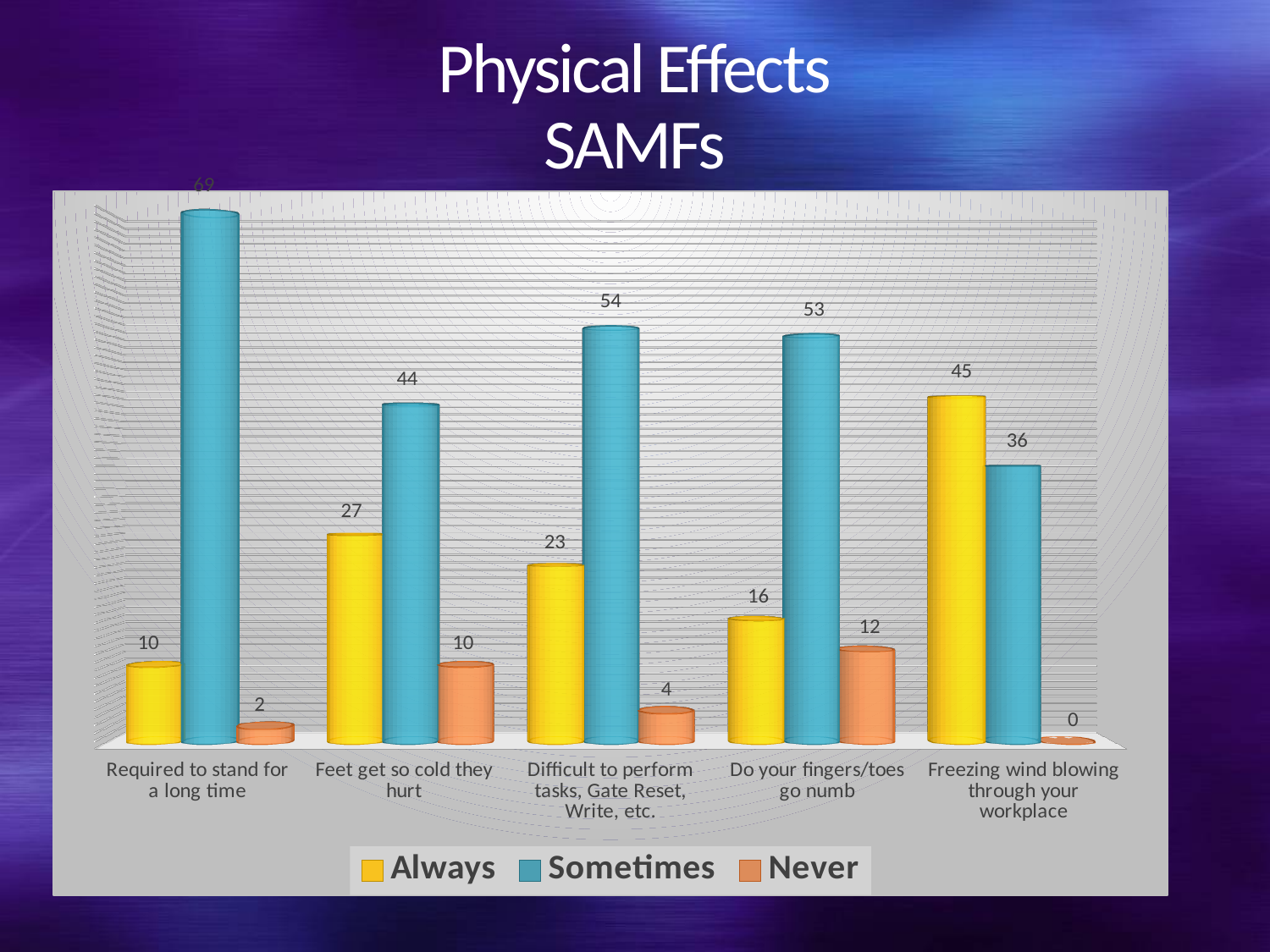
What is the Always value for "Feet get so cold they hurt"? 27 How many categories are shown on the x axis? 5 For "Freezing wind blowing through your workplace", which is larger, the Always value or the Sometimes value? Always Which series is shown in orange in the legend? Never What is the difference between the Sometimes and Always values for "Feet get so cold they hurt"? 17 How many series does the legend list? 3 What kind of chart is shown on the slide? Bar chart What is the Never value for "Do your fingers/toes go numb"? 12 Which category has the lowest Never value? Freezing wind blowing through your workplace What is the Sometimes value for "Difficult to perform tasks, Gate Reset, Write, etc."? 54 What is the Always value for "Freezing wind blowing through your workplace"? 45 Which category has the tallest Sometimes bar? Required to stand for a long time